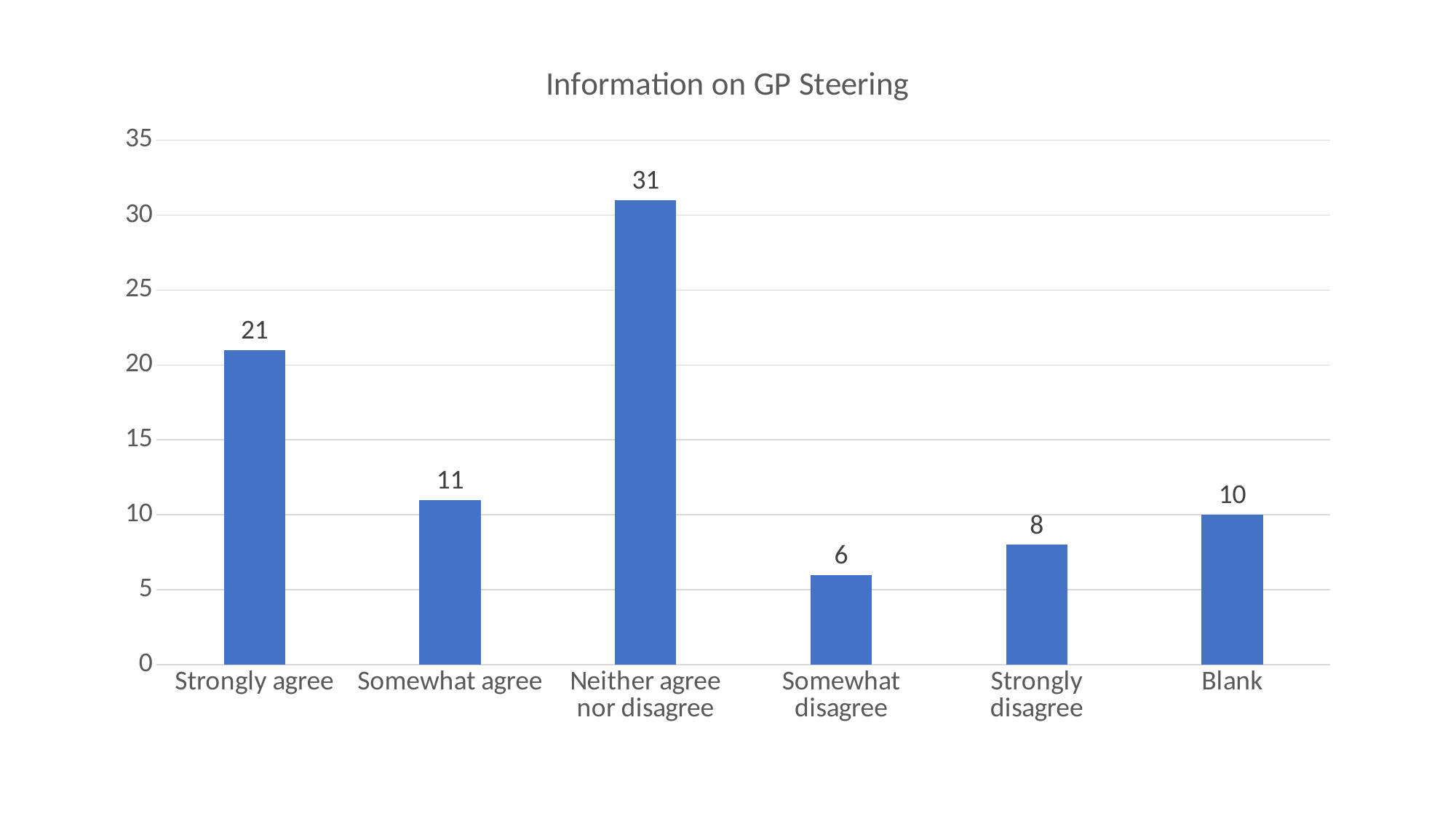
What is the difference between the values for Strongly agree and Somewhat agree? 10 What kind of chart is this? bar chart Which category has the lowest value? Somewhat disagree What is the value for Blank? 10 How many categories are shown on the x axis? 6 What is the title of the chart? Information on GP Steering What is the value for Neither agree nor disagree? 31 Is the value for Somewhat agree greater or less than 15? less What is the value for Strongly agree? 21 What is the difference between the values for Neither agree nor disagree and Blank? 21 Which category has the highest value? Neither agree nor disagree Which is larger, the value for Strongly disagree or the value for Blank? Blank